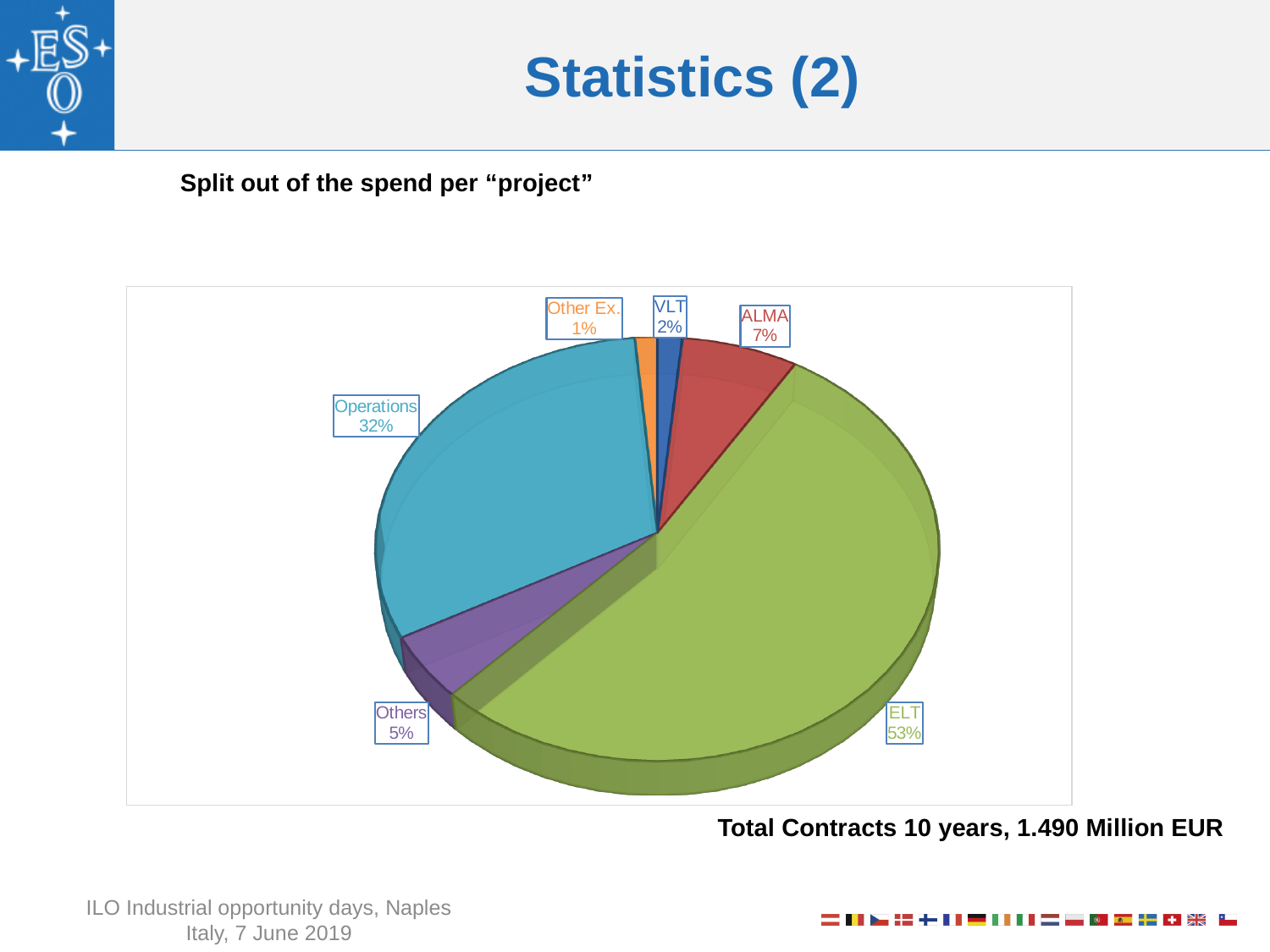
What is the combined share of ALMA and VLT? 9% Which project has the largest share of the spend? ELT What colour is the ELT slice? green Which has a larger share of the spend, ALMA or Others? ALMA How many slices does the pie chart have? 6 What share of the spend does VLT account for? 2% What is the difference in percentage points between the ELT and Operations shares? 21 What kind of chart is shown on the slide? pie chart Which project has the smallest share of the spend? Other Ex. What share of the spend does ELT account for? 53% What share of the spend does ALMA account for? 7% What share of the spend does Operations account for? 32%